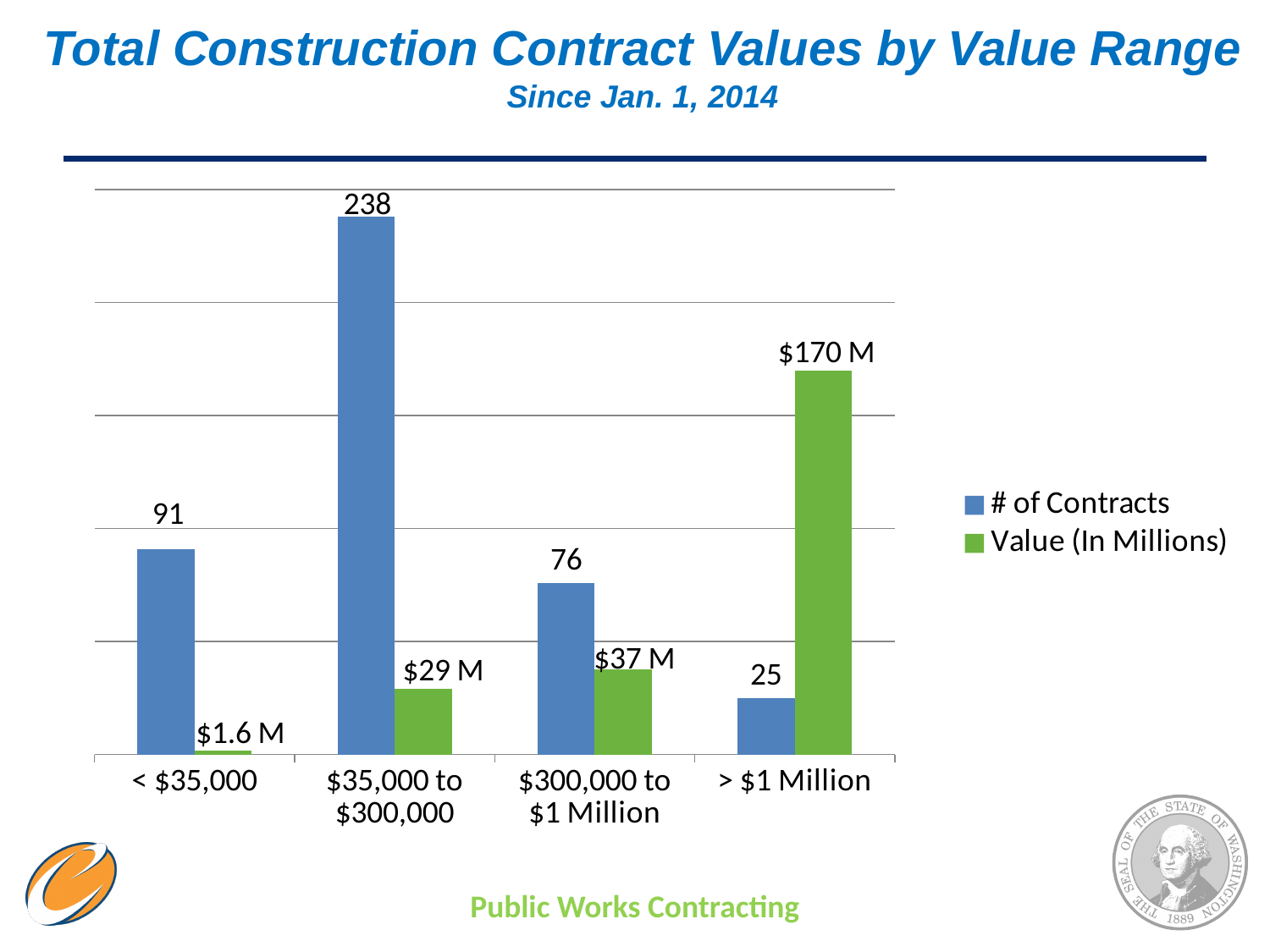
How many contracts are in the > $1 Million range? 25 How many contracts are in the $35,000 to $300,000 range? 238 What kind of chart is shown on the slide? Bar chart Which value range has the lowest value in millions? < $35,000 Which value range has the highest number of contracts? $35,000 to $300,000 How many value ranges are shown on the x axis? 4 What is the value (in millions) for the > $1 Million range? $170 M What is the value (in millions) for the < $35,000 range? $1.6 M Which series is shown in green in the legend? Value (In Millions) Which is larger: the value for the $300,000 to $1 Million range or the value for the $35,000 to $300,000 range? $300,000 to $1 Million What is the difference in number of contracts between the $35,000 to $300,000 range and the $300,000 to $1 Million range? 162 How many series does the legend list? 2